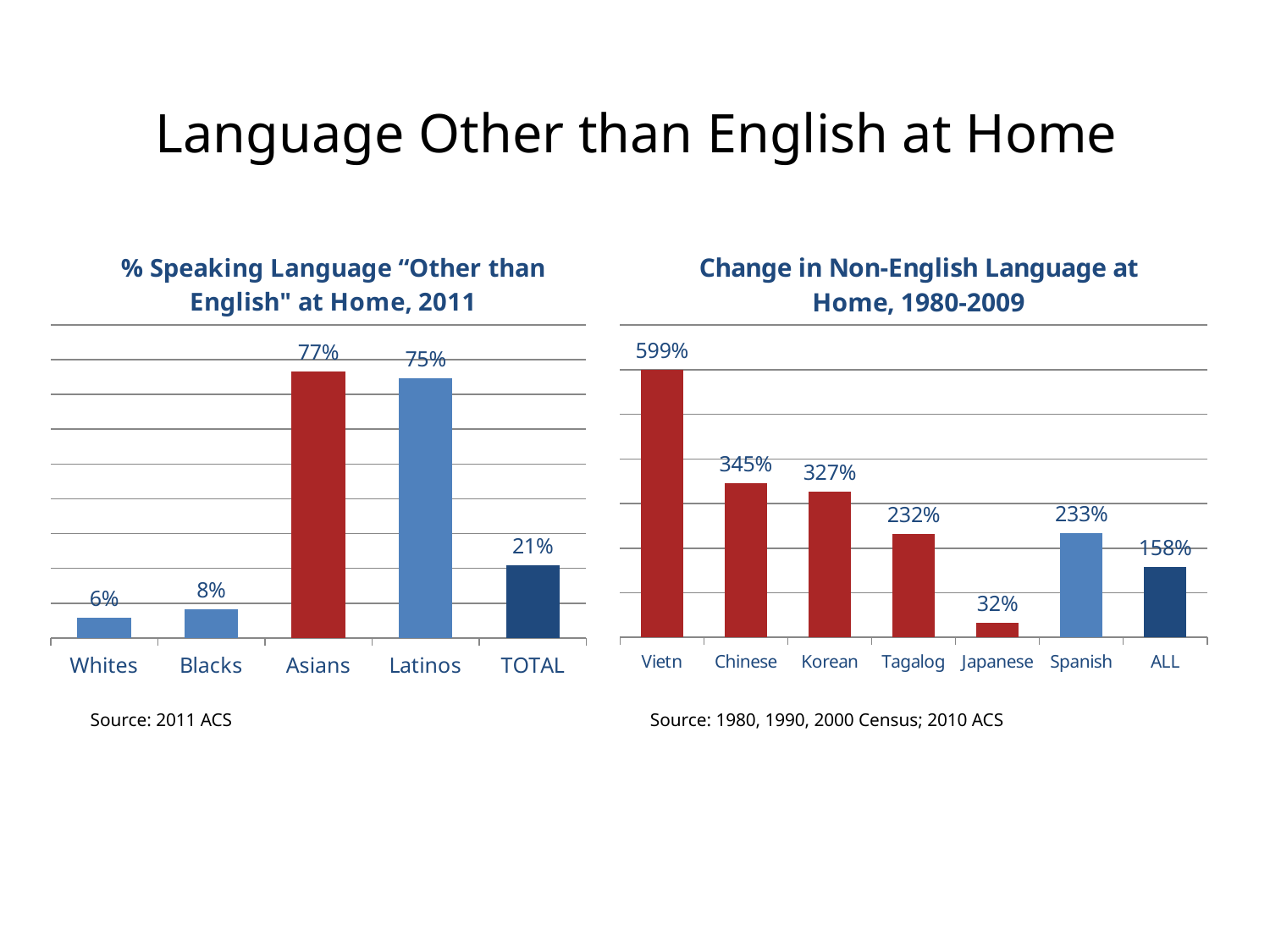
In the right chart, 'Change in Non-English Language at Home, 1980-2009', what is the difference between the values for Vietn and Chinese? 254% In the right chart, 'Change in Non-English Language at Home, 1980-2009', which is larger, the value for Tagalog or the value for ALL? Tagalog In the right chart, 'Change in Non-English Language at Home, 1980-2009', what is the value for Spanish? 233% In the right chart, 'Change in Non-English Language at Home, 1980-2009', which category has the highest value? Vietn In the left chart, '% Speaking Language "Other than English" at Home, 2011', what is the value for TOTAL? 21% In the left chart, '% Speaking Language "Other than English" at Home, 2011', which category has the lowest value? Whites In the left chart, '% Speaking Language "Other than English" at Home, 2011', what is the difference between the values for Asians and Latinos? 2% In the left chart, '% Speaking Language "Other than English" at Home, 2011', what is the value for Asians? 77% What kind of chart is the right chart, 'Change in Non-English Language at Home, 1980-2009'? Bar chart In the right chart, 'Change in Non-English Language at Home, 1980-2009', what is the value for Korean? 327% In the right chart, 'Change in Non-English Language at Home, 1980-2009', which category has the lowest value? Japanese In the left chart, '% Speaking Language "Other than English" at Home, 2011', how many categories are shown? 5